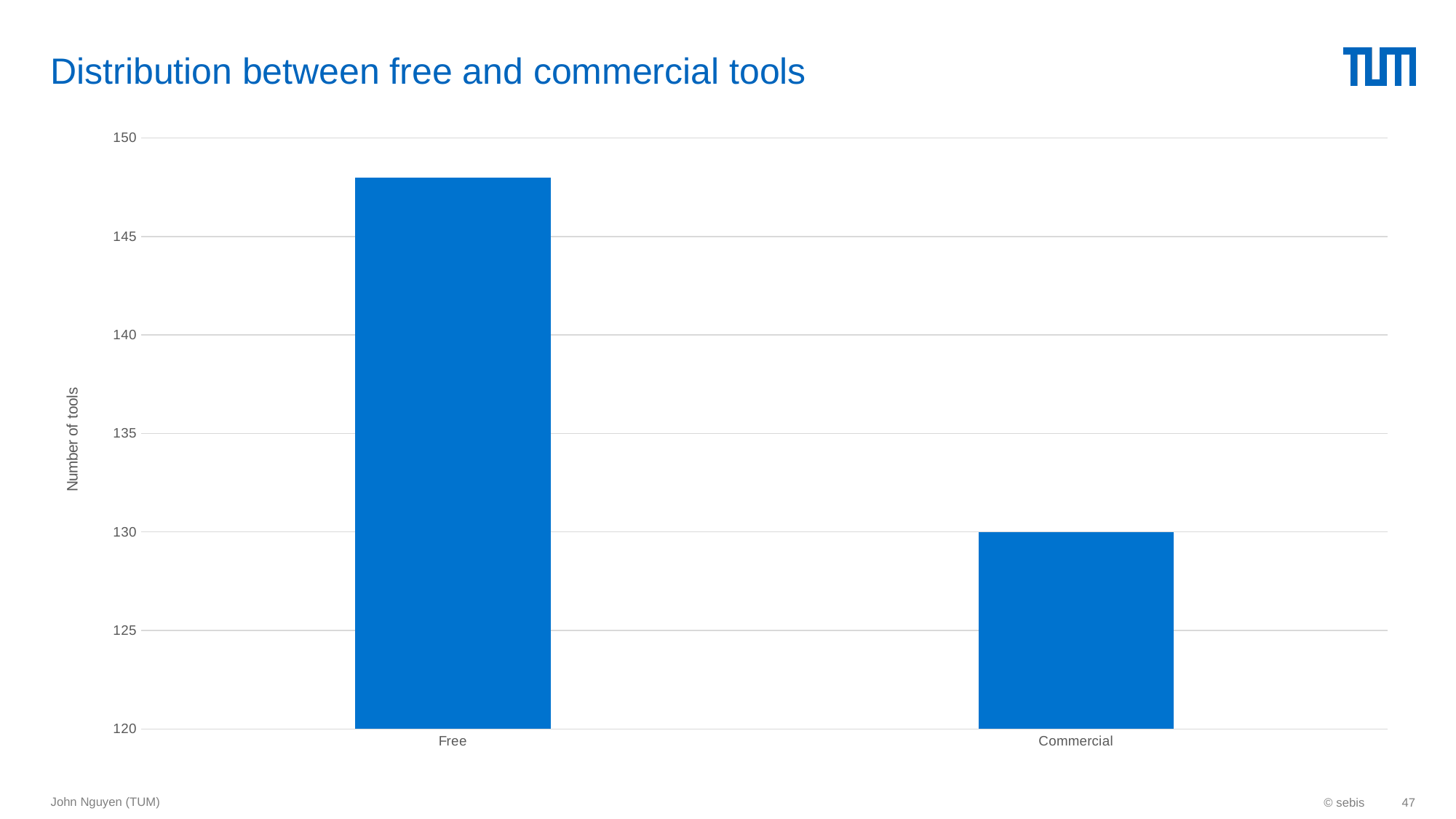
Do the values rise or fall from Free to Commercial along the x axis? fall Is the value for Free greater or less than 150? less What is the label of the y axis? Number of tools What is the number of tools for Commercial? 130 Which category has the highest number of tools? Free Is the value for Commercial greater or less than 135? less Which category has the lowest number of tools? Commercial What is the title of the chart on the slide? Distribution between free and commercial tools How many categories are shown on the x axis of the chart? 2 Which has more tools, Free or Commercial? Free Is the value for Free greater or less than 145? greater What kind of chart is shown on the slide? bar chart